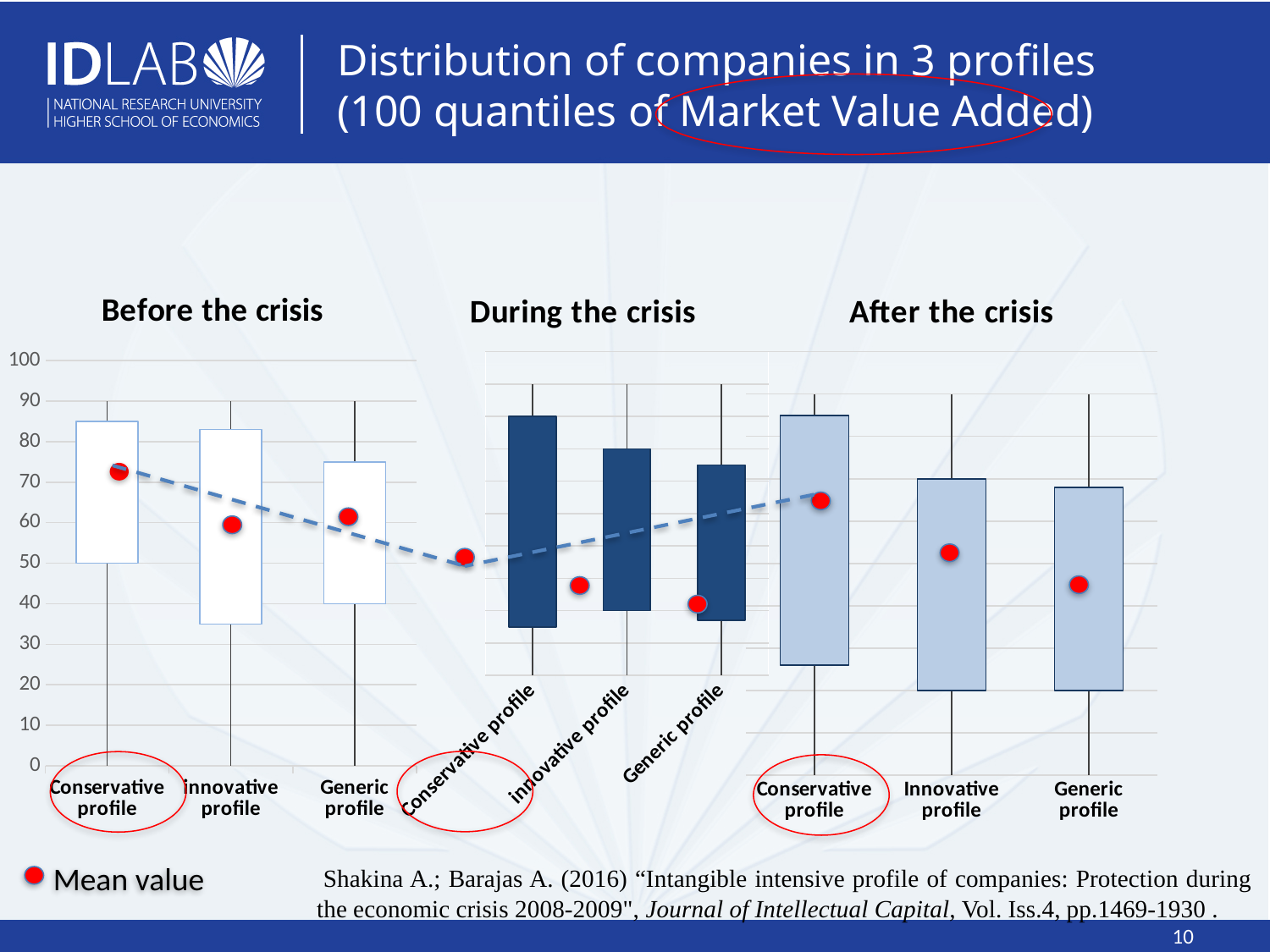
Is the mean value for the Conservative profile larger before the crisis or during the crisis? Before the crisis In the 'During the crisis' chart, which profile has the highest mean value? Conservative profile In the 'After the crisis' chart, do the mean values rise or fall from the Conservative profile to the Generic profile? fall What kind of chart is shown on the slide? Box plot How many separate charts (crisis periods) are shown on the slide? 3 In the 'Before the crisis' chart, is the mean value for the Conservative profile greater or less than 60? greater What is the title of the slide's chart? Distribution of companies in 3 profiles (100 quantiles of Market Value Added) What do the red dots on the charts represent, according to the legend? Mean value How many profile categories does the 'Before the crisis' chart show? 3 In the 'Before the crisis' chart, which profile has the highest mean value? Conservative profile In the 'After the crisis' chart, which profile has the lowest mean value? Generic profile In the 'Before the crisis' chart, is the mean value for the Innovative profile greater or less than 70? less